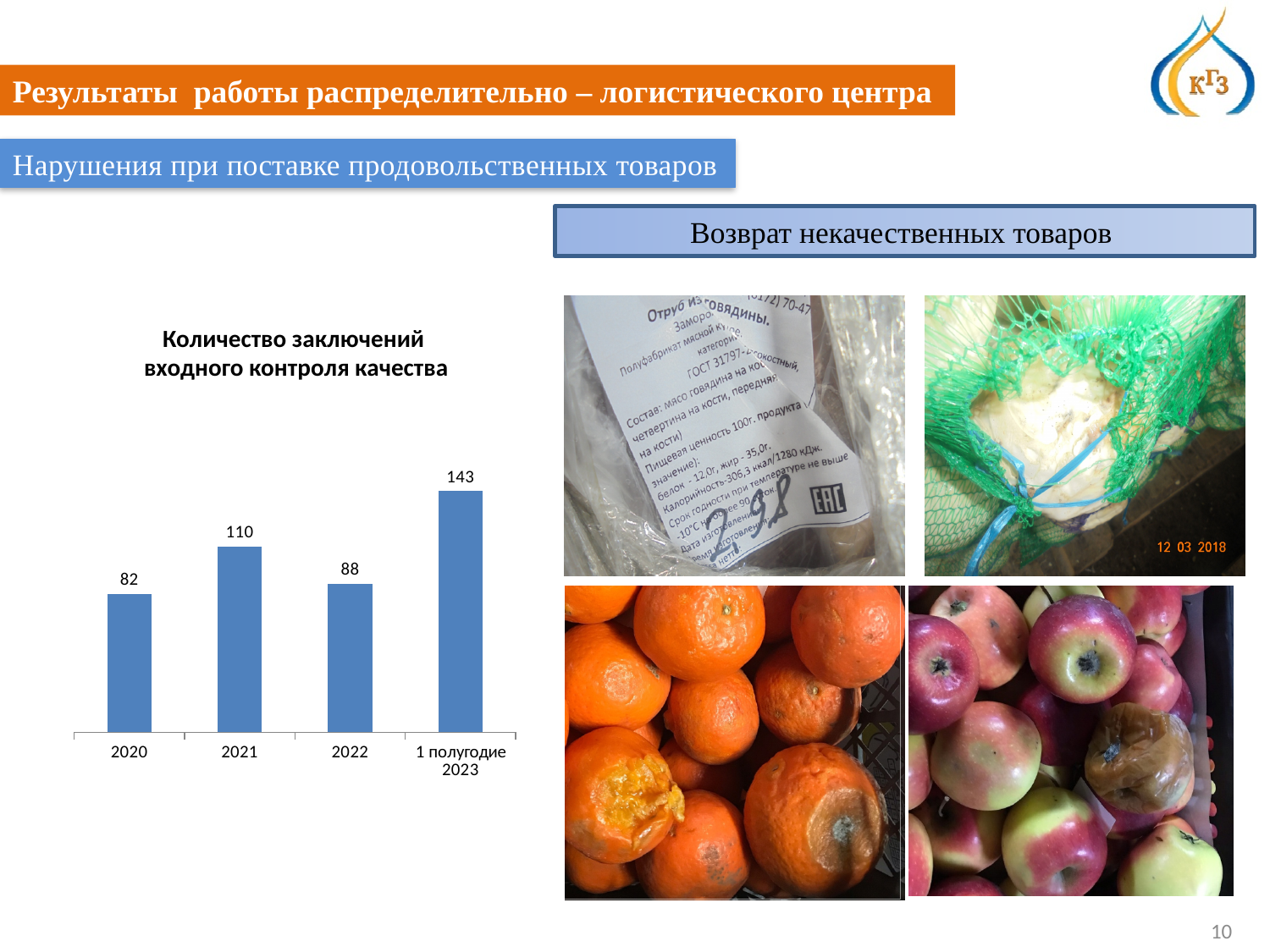
What kind of chart is shown on the slide? bar chart What is the difference between the values for 2021 and 2020? 28 Which category has the highest value in the chart? 1 полугодие 2023 Which category has the lowest value in the chart? 2020 How many categories are shown on the x axis of the chart? 4 What is the difference between the values for 1 полугодие 2023 and 2022? 55 What is the value for 2020 in the chart 'Количество заключений входного контроля качества'? 82 What is the value for 2022 in the chart? 88 What is the value for '1 полугодие 2023' in the chart? 143 What is the value for 2021 in the chart? 110 What is the title of the chart on the slide? Количество заключений входного контроля качества Which is larger, the value for 2021 or the value for 2022? 2021